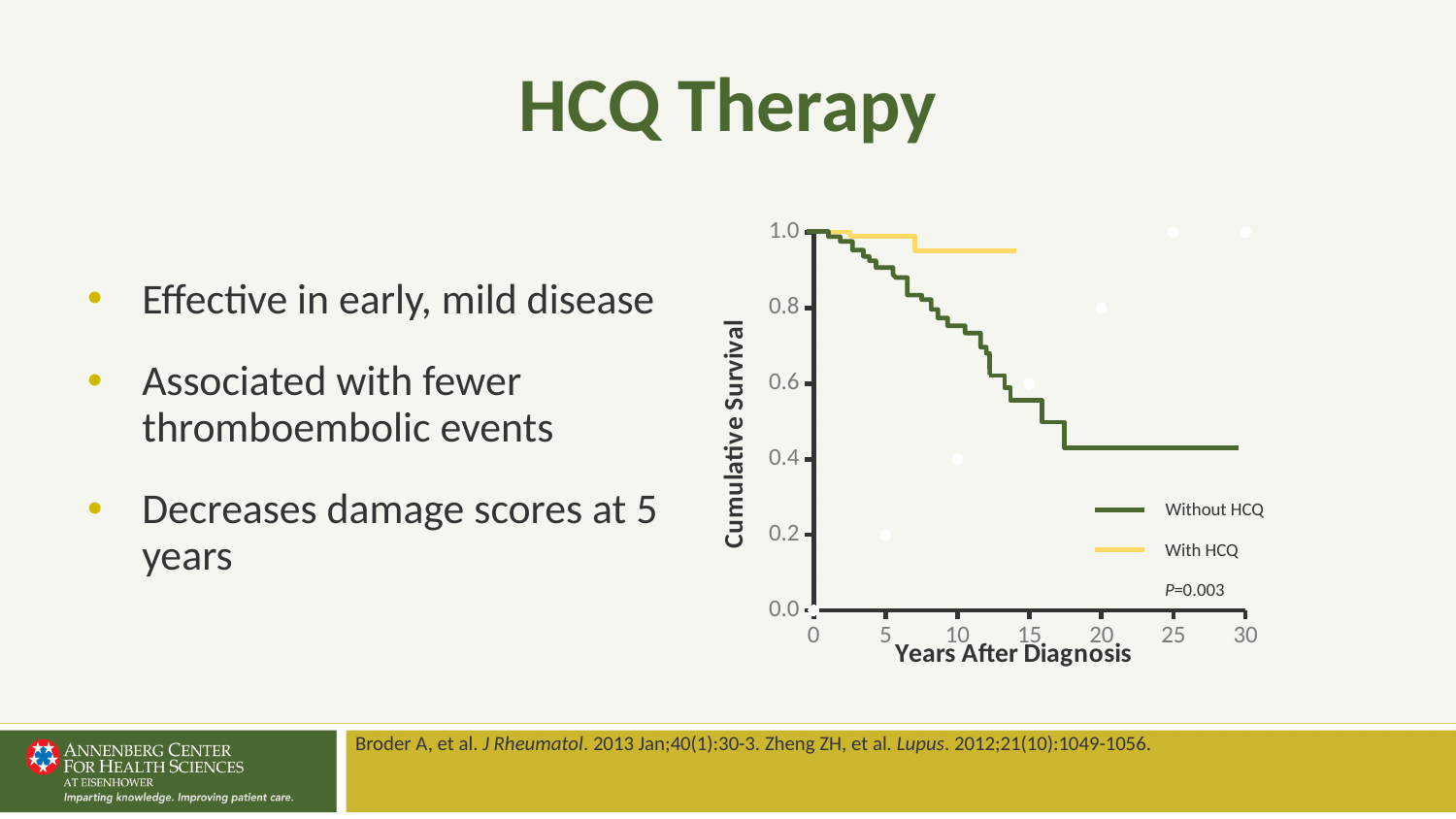
What is the title of the chart's y axis? Cumulative Survival What kind of chart is shown on the slide? Line chart What is the title of the chart's x axis? Years After Diagnosis Which series is drawn in yellow on the chart? With HCQ How many series does the chart's legend list? 2 Is the cumulative survival for Without HCQ at 5 years greater or less than 0.8? greater Is the cumulative survival for With HCQ at 10 years greater or less than 0.8? greater Is the cumulative survival for Without HCQ at 15 years greater or less than 0.8? less At 10 years after diagnosis, which series has the higher cumulative survival, With HCQ or Without HCQ? With HCQ Does the Without HCQ curve rise or fall as years after diagnosis increase? Fall